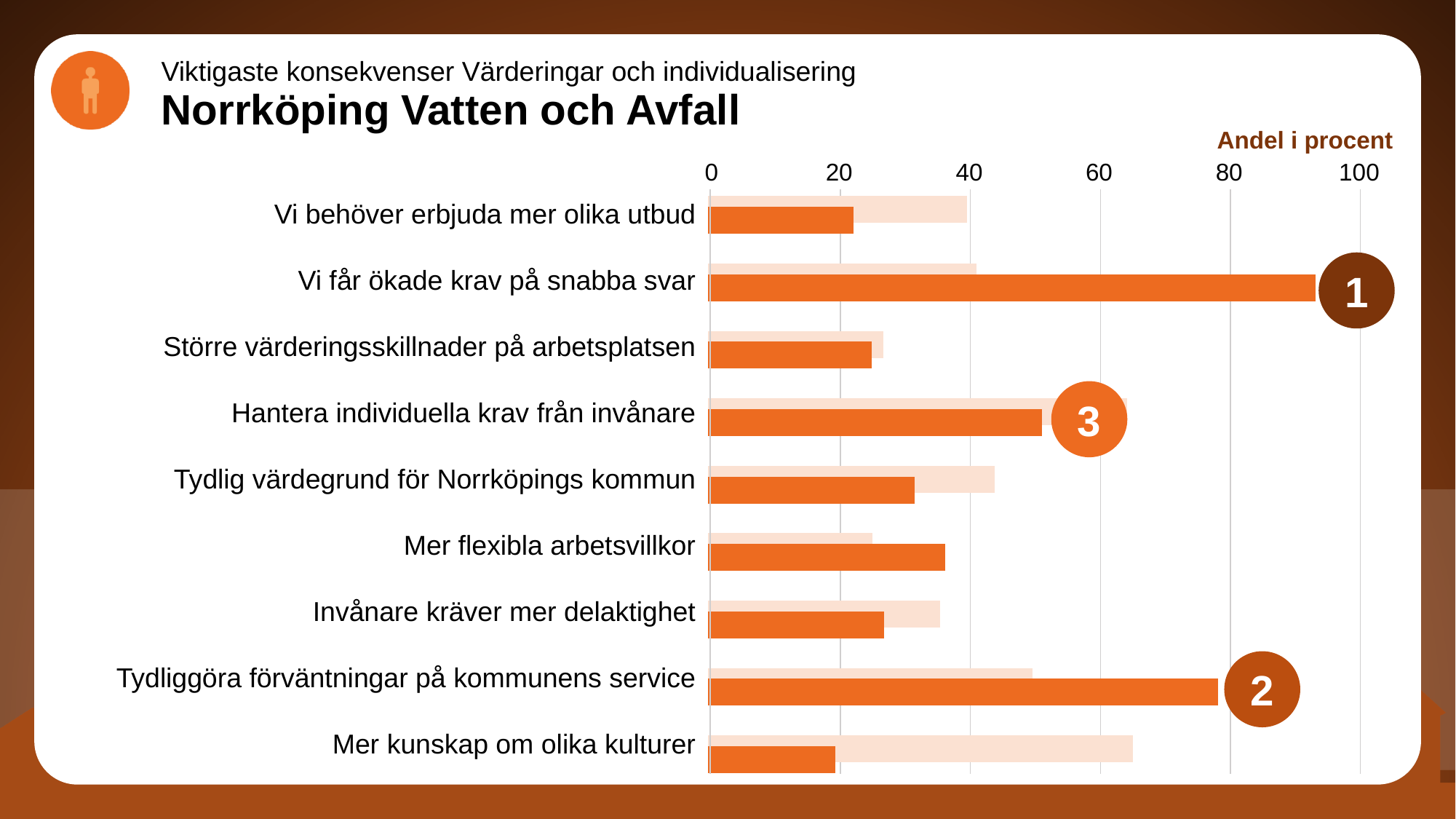
How many categories are listed on the chart? 9 Is the dark orange bar for "Hantera individuella krav från invånare" greater or less than 40? greater Is the dark orange bar for "Vi får ökade krav på snabba svar" greater or less than 80? greater Is the dark orange bar for "Vi behöver erbjuda mer olika utbud" greater or less than 40? less What kind of chart is shown on the slide? bar chart Which has the longer dark orange bar: "Tydliggöra förväntningar på kommunens service" or "Hantera individuella krav från invånare"? Tydliggöra förväntningar på kommunens service Which has the longer light orange bar: "Hantera individuella krav från invånare" or "Tydliggöra förväntningar på kommunens service"? Hantera individuella krav från invånare Which category is marked with the circled number 2? Tydliggöra förväntningar på kommunens service Which category has the longest dark orange bar? Vi får ökade krav på snabba svar What label is shown above the horizontal axis of the chart? Andel i procent